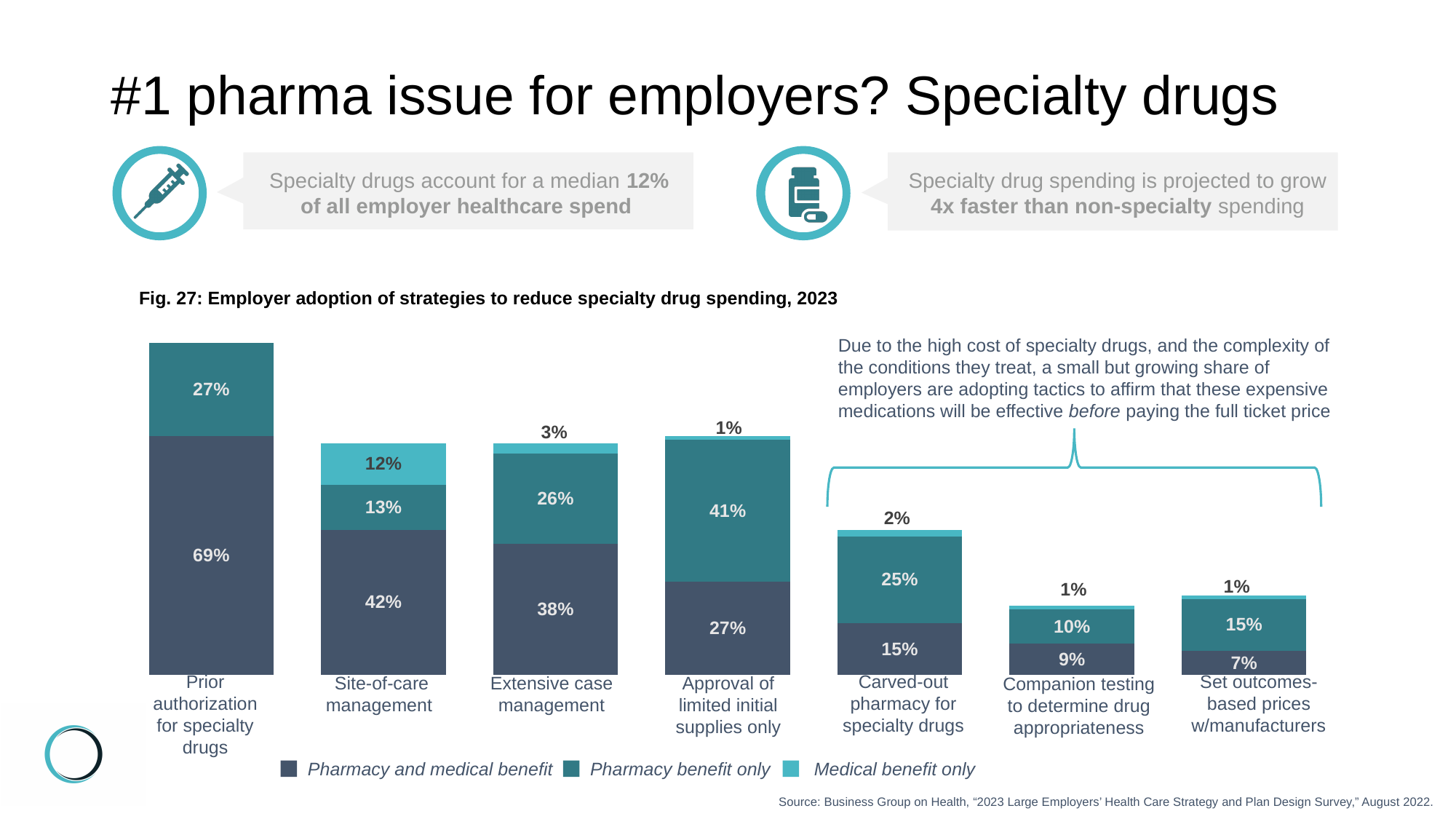
Which strategy has the highest value for Pharmacy and medical benefit? Prior authorization for specialty drugs What kind of chart is shown? Stacked bar chart What is the difference between the Pharmacy benefit only values for Approval of limited initial supplies only and Carved-out pharmacy for specialty drugs? 16 percentage points How many strategies (categories) are shown on the x axis? 7 What is the value for Pharmacy and medical benefit for Prior authorization for specialty drugs? 69% What is the total of the stacked bar for Companion testing to determine drug appropriateness? 20% How many series does the legend list? 3 What is the total of the stacked bar for Site-of-care management? 67% What is the value for Medical benefit only for Site-of-care management? 12% Which strategy has the lowest value for Pharmacy and medical benefit? Set outcomes-based prices w/manufacturers What is the value for Pharmacy benefit only for Approval of limited initial supplies only? 41% Which has the larger Pharmacy and medical benefit value: Site-of-care management or Extensive case management? Site-of-care management